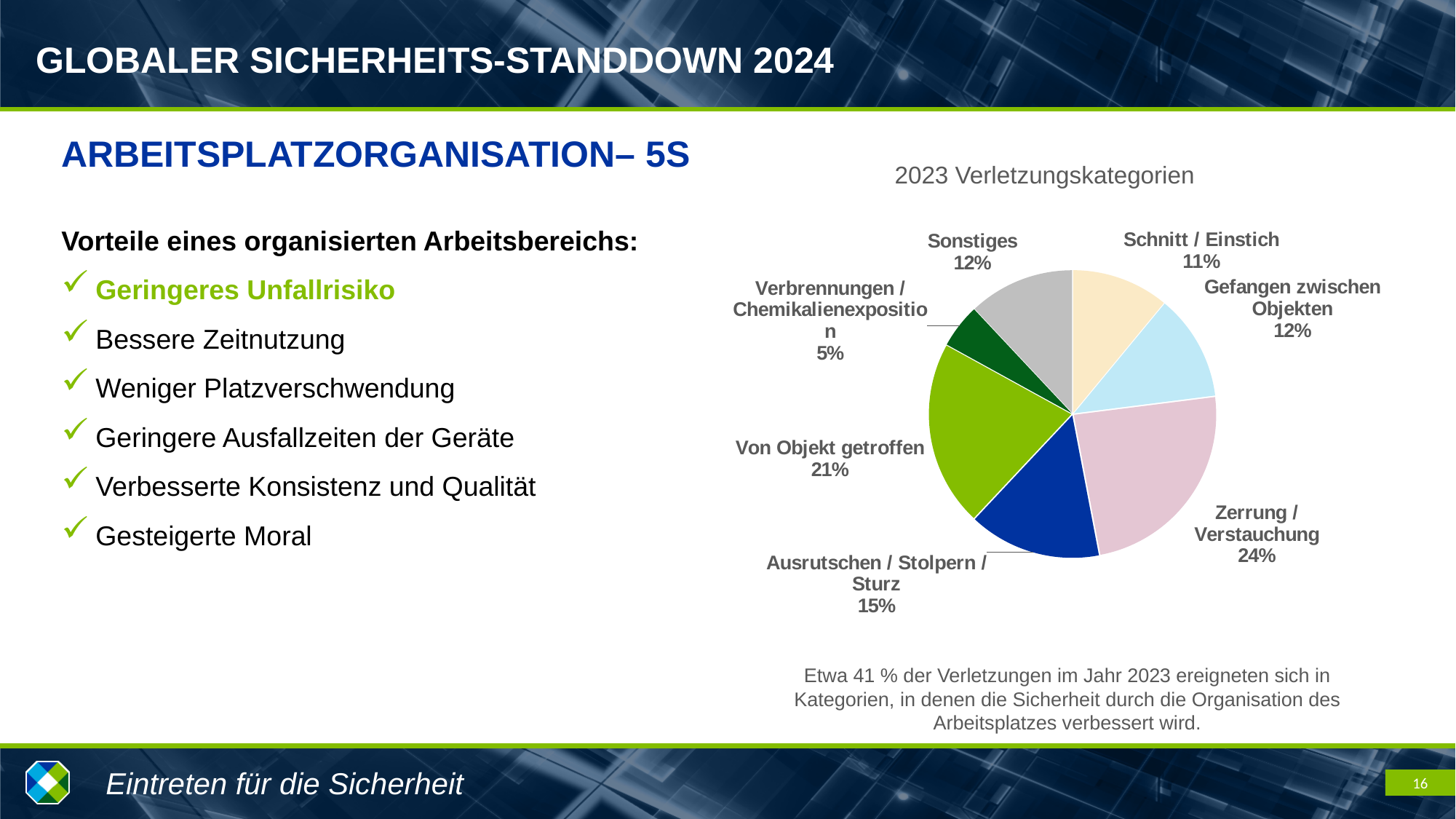
What is the difference in percentage points between Zerrung / Verstauchung and Ausrutschen / Stolpern / Sturz? 9 Which injury category has the smallest share of the pie? Verbrennungen / Chemikalienexposition What share of injuries is attributed to Von Objekt getroffen? 21% What is the title of the chart? 2023 Verletzungskategorien What share of injuries is attributed to Zerrung / Verstauchung? 24% Which injury category has the largest share of the pie? Zerrung / Verstauchung Which has a larger share, Schnitt / Einstich or Von Objekt getroffen? Von Objekt getroffen What share of injuries is attributed to Ausrutschen / Stolpern / Sturz? 15% What type of chart is shown on the slide? pie chart What share of injuries is attributed to Verbrennungen / Chemikalienexposition? 5% How many categories are shown in the pie chart? 7 What is the combined share of Sonstiges and Gefangen zwischen Objekten? 24%